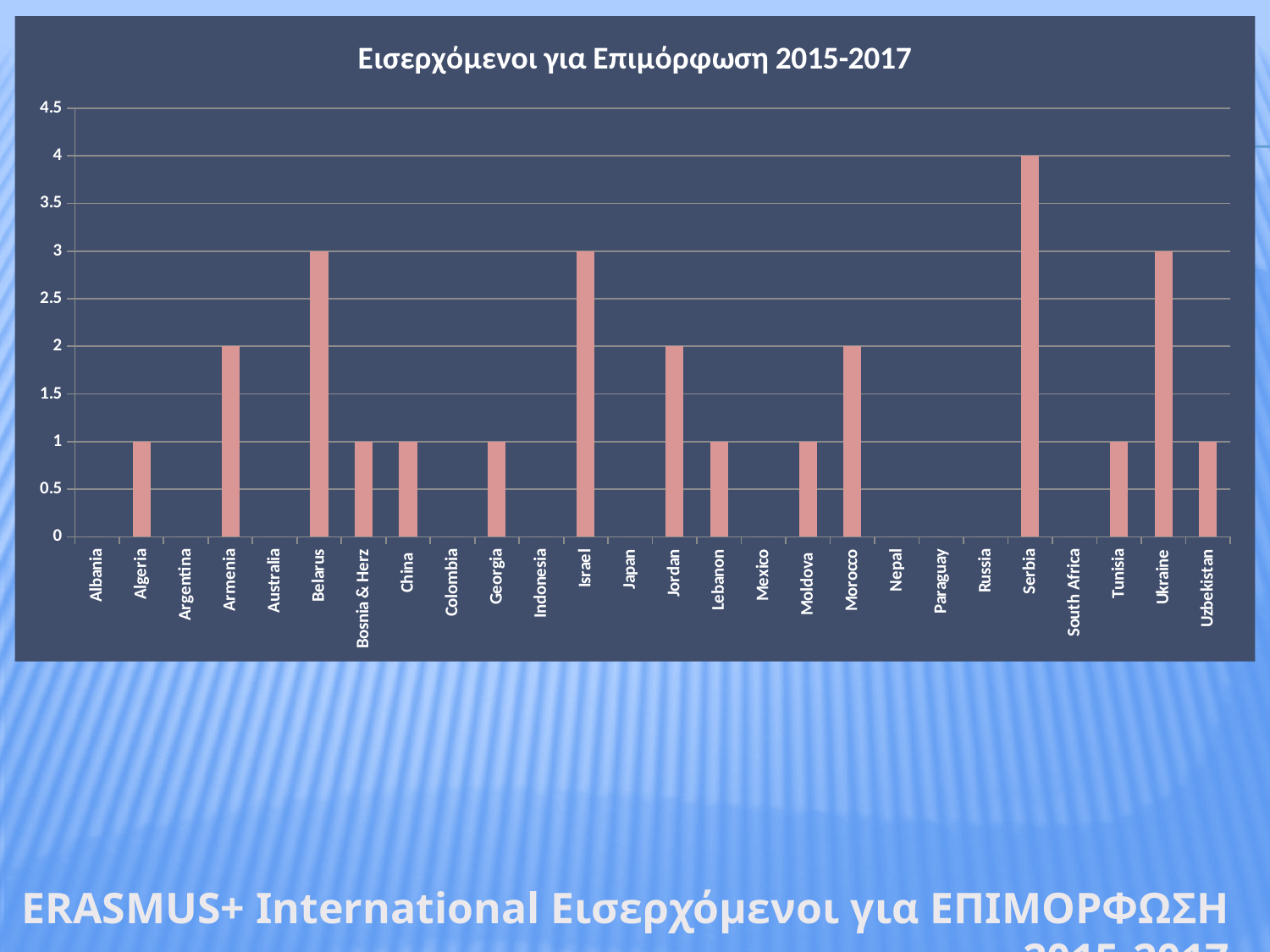
What is the title of the chart? Εισερχόμενοι για Επιμόρφωση 2015-2017 What kind of chart is shown on the slide? bar chart What is the value for Morocco? 2 What is the value for Belarus? 3 What is the value for Serbia? 4 Is the value for Serbia greater or less than 3.5? greater Which country has the highest value in the chart? Serbia Which is larger, the value for Israel or the value for Jordan? Israel What is the difference between the values for Serbia and Ukraine? 1 How many countries are listed on the x axis of the chart? 26 What is the value for Armenia? 2 What is the value for Algeria? 1